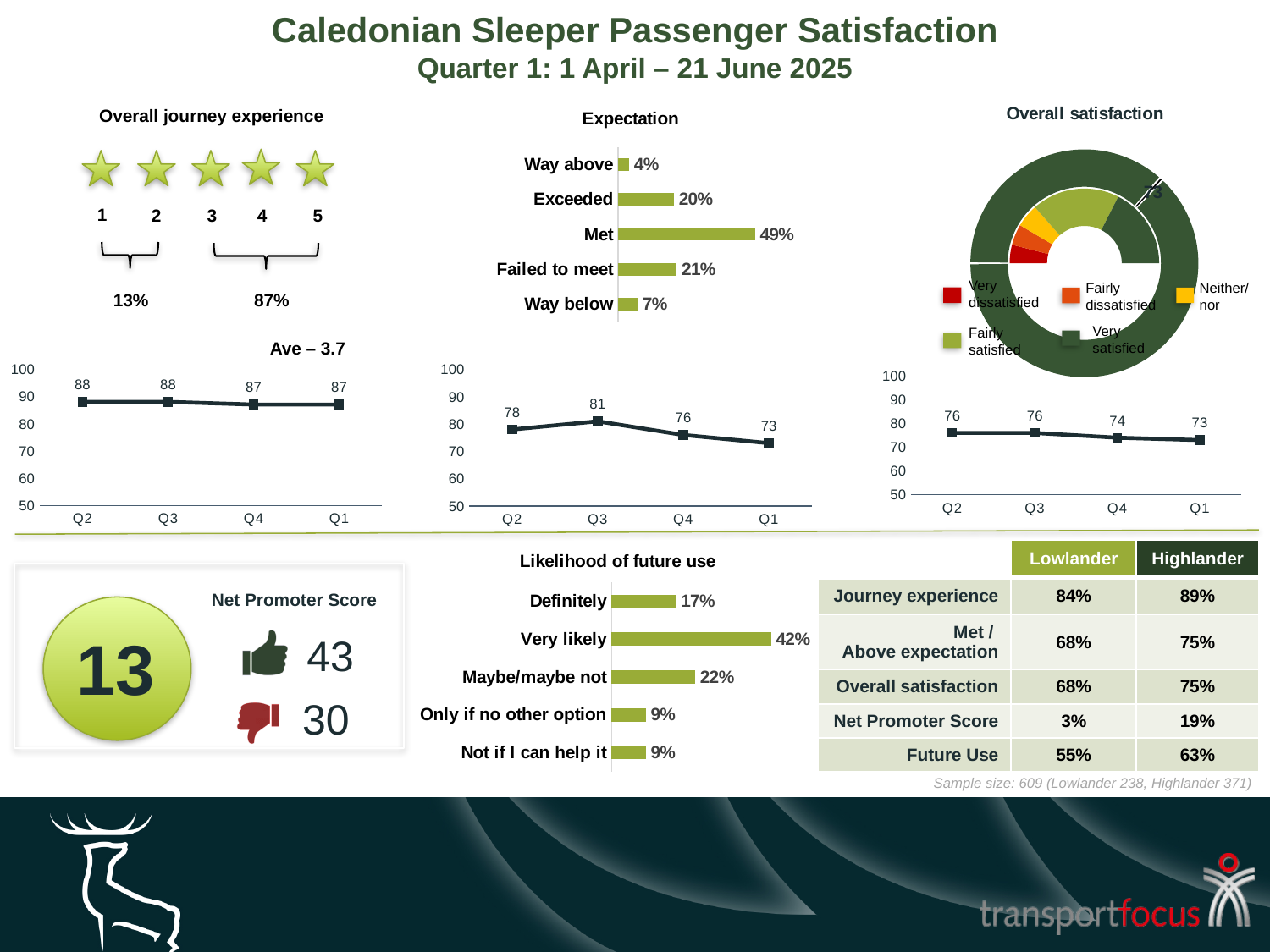
What kind of chart is used to show Expectation percentages (Way above, Exceeded, Met, etc.)? bar chart In the Likelihood of future use bar chart, which category has the highest value? Very likely In the line chart under Overall journey experience, what is the value for Q1? 87 In the Likelihood of future use bar chart, what is the value for 'Maybe/maybe not'? 22% In the line chart under Expectation, what is the difference between the Q3 and Q1 values? 8 How many categories are shown in the Likelihood of future use bar chart? 5 In the Expectation bar chart, which category has the lowest value? Way above In the line chart under Expectation, which quarter has the highest value? Q3 In the line chart under Overall satisfaction, do the values rise or fall from Q2 to Q1? fall In the Expectation bar chart, what percentage of passengers said their expectations were met? 49% In the Expectation bar chart, what is the difference between the 'Failed to meet' and 'Exceeded' values? 1% How many legend entries does the Overall satisfaction donut chart list? 5